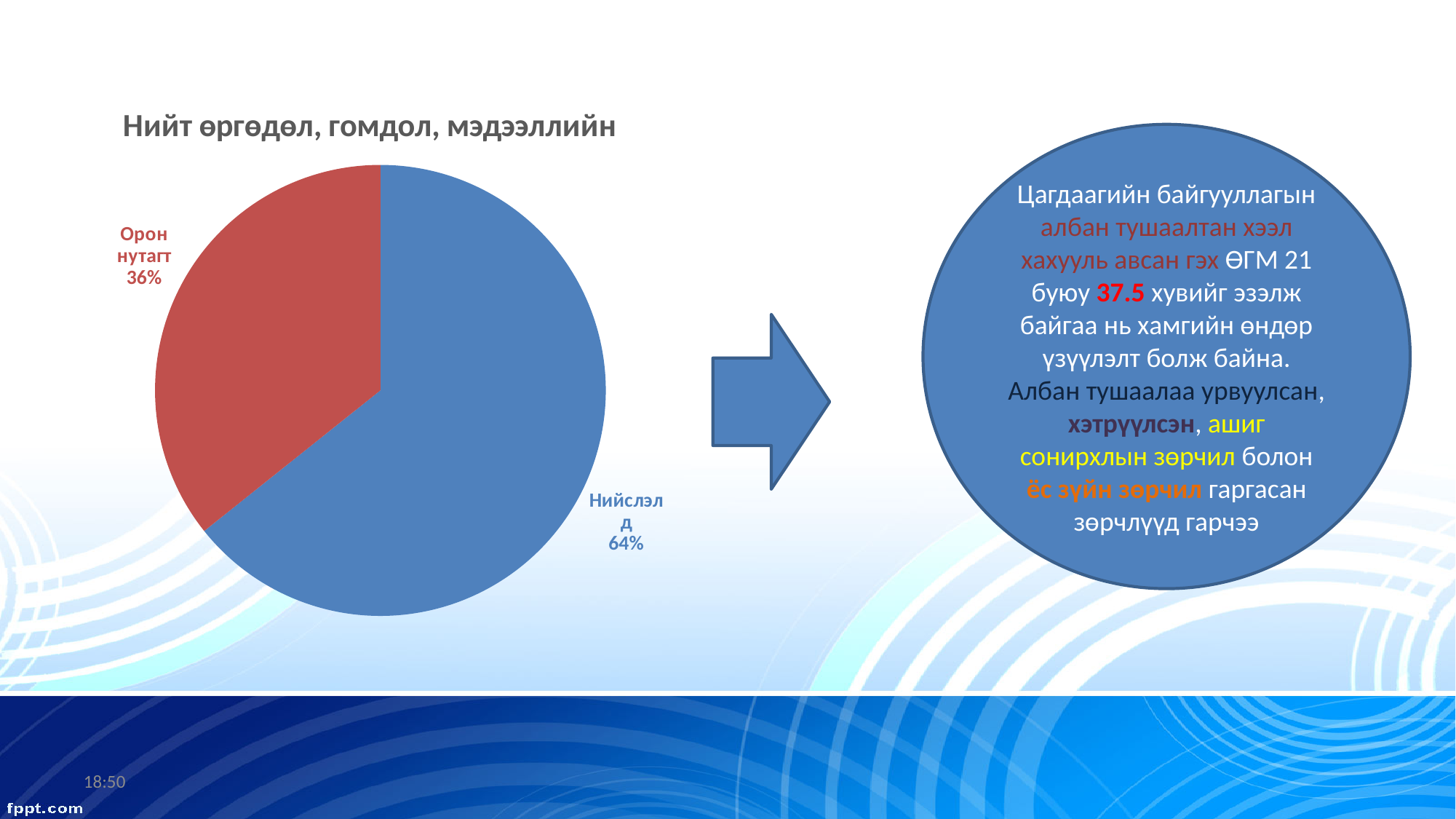
What is the title of the chart? Нийт өргөдөл, гомдол, мэдээллийн What colour is the Орон нутагт slice? Red How many slices does the pie chart have? 2 What kind of chart is shown on the slide? Pie chart What share of the pie does Нийслэлд have? 64% Which slice of the pie is the largest? Нийслэлд What share of the pie does Орон нутагт have? 36% Which is larger, the share for Нийслэлд or the share for Орон нутагт? Нийслэлд What is the difference in percentage points between Нийслэлд and Орон нутагт? 28 percentage points Which slice of the pie is the smallest? Орон нутагт